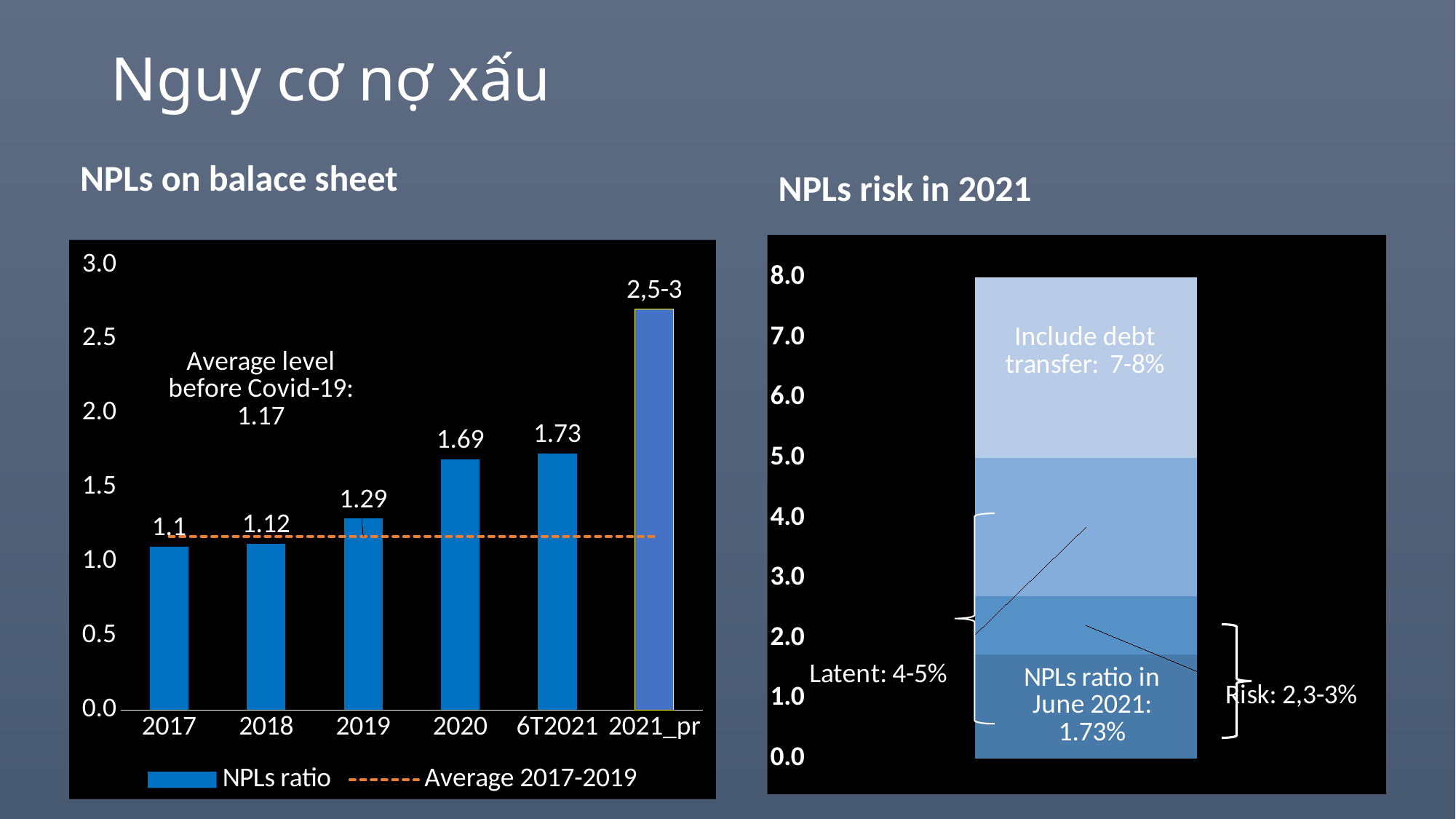
In the 'NPLs on balace sheet' chart, is the NPLs ratio higher in 2018 or in 2020? 2020 In the 'NPLs on balace sheet' chart, what value is labelled on the 2021_pr bar? 2,5-3 In the 'NPLs on balace sheet' chart, what is the NPLs ratio for 6T2021? 1.73 In the 'NPLs on balace sheet' chart, what is the NPLs ratio for 2020? 1.69 In the 'NPLs on balace sheet' chart, do the NPLs ratio values rise or fall from 2017 to 6T2021? rise In the 'NPLs on balace sheet' chart, which year among 2017, 2018 and 2019 has the lowest NPLs ratio? 2017 In the 'NPLs on balace sheet' chart, how many categories are shown on the x axis? 6 What kind of chart is 'NPLs on balace sheet'? bar chart In the 'NPLs on balace sheet' chart, what is the difference between the NPLs ratio in 2020 and in 2019? 0.4 In the 'NPLs on balace sheet' chart, what is the average level before Covid-19 stated on the chart? 1.17 In the 'NPLs risk in 2021' chart, what value is given for the 'Latent' segment? 4-5% In the 'NPLs on balace sheet' chart, how many series does the legend list? 2